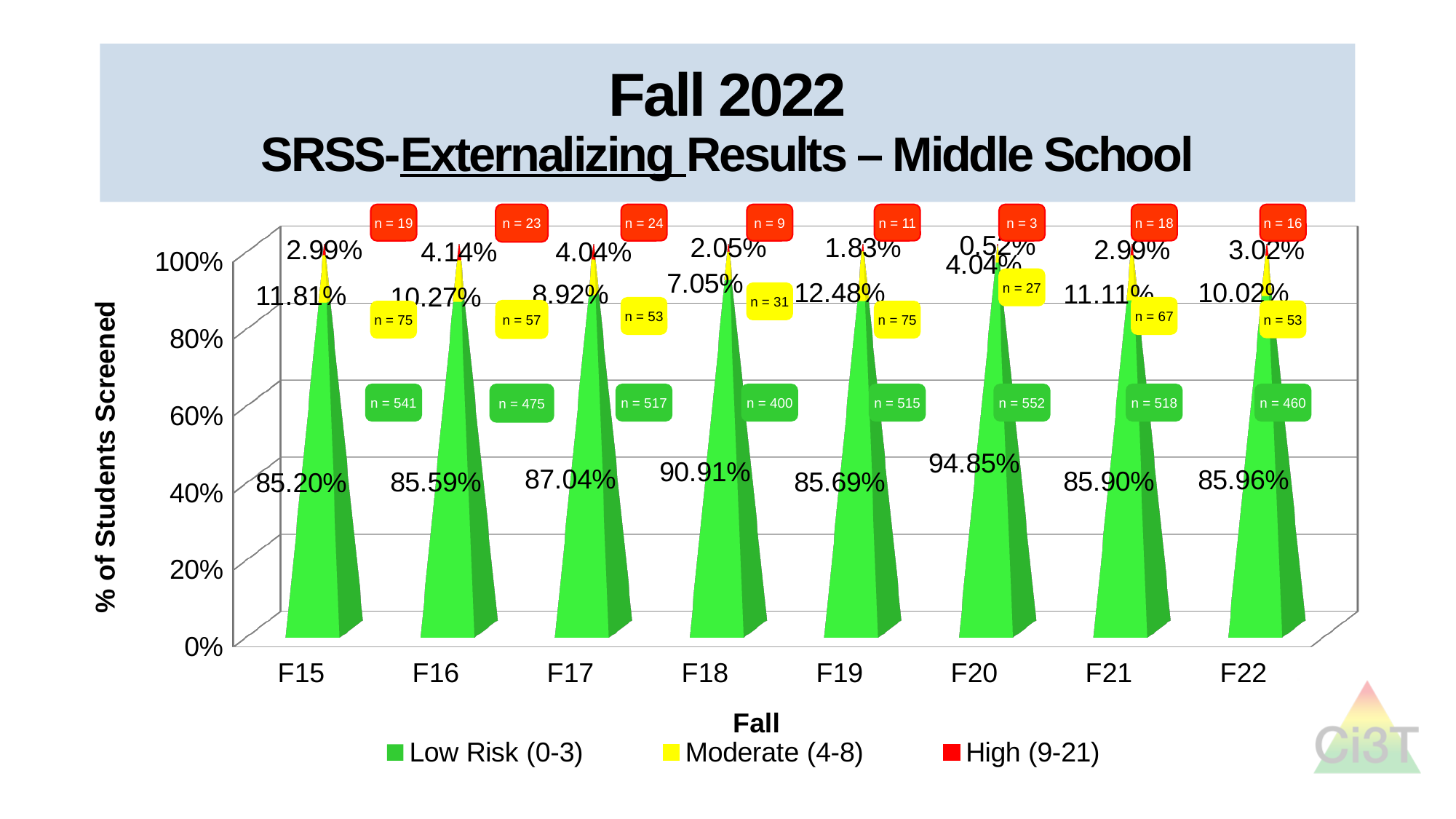
How many series does the legend list? 3 What percentage of students screened were Moderate (4-8) in F19? 12.48% How much higher is the Low Risk (0-3) percentage in F20 than in F15? 9.65% How many students were in the Low Risk (0-3) group in F20 according to the n label? 552 What percentage of students screened were Low Risk (0-3) in F18? 90.91% In which fall was the Low Risk (0-3) percentage highest? F20 How many fall time points are shown on the x axis? 8 Does the Low Risk (0-3) percentage rise or fall from F15 to F18? rise What percentage of students screened were High (9-21) in F20? 0.52% In which fall was the Moderate (4-8) percentage highest? F19 Which fall had a larger Moderate (4-8) percentage, F16 or F22? F16 In which fall was the High (9-21) percentage lowest? F20